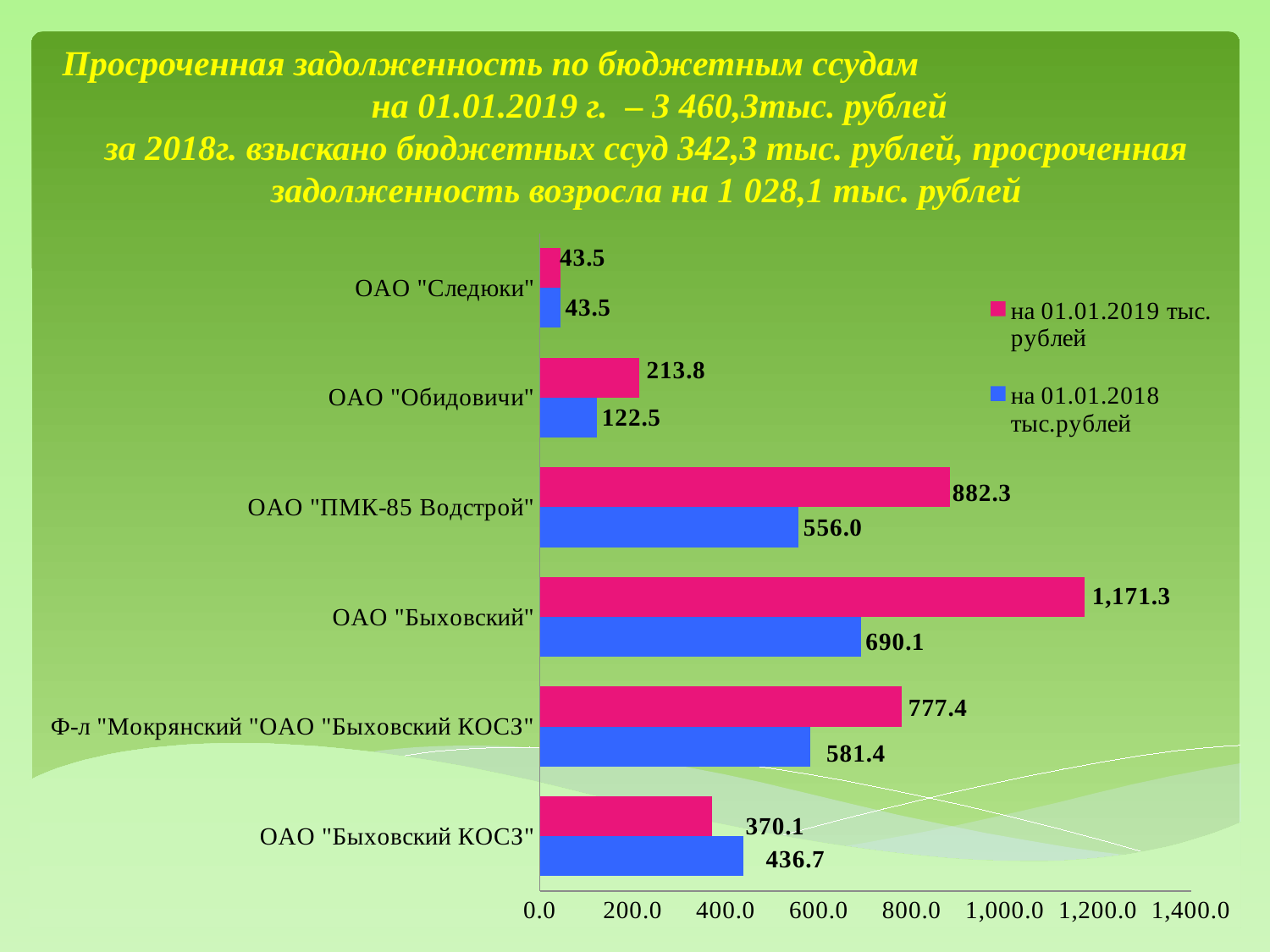
What kind of chart is shown on the slide? bar chart What is the value for ОАО "Быховский" in the series "на 01.01.2019 тыс. рублей"? 1,171.3 How many categories (organisations) are shown on the chart? 6 How many series does the legend list? 2 For ОАО "Быховский КОСЗ", which is larger: the value on 01.01.2019 or on 01.01.2018? 01.01.2018 What is the value for ОАО "Обидовичи" in the series "на 01.01.2019 тыс. рублей"? 213.8 Is the value for ОАО "ПМК-85 Водстрой" on 01.01.2019 greater or less than 800.0? greater What is the difference between the 01.01.2019 and 01.01.2018 values for ОАО "Быховский"? 481.2 What is the value for ОАО "ПМК-85 Водстрой" in the series "на 01.01.2018 тыс.рублей"? 556.0 Which category has the highest value in the series "на 01.01.2019 тыс. рублей"? ОАО "Быховский" Which colour represents the series "на 01.01.2018 тыс.рублей"? blue Which category has the lowest value in the series "на 01.01.2018 тыс.рублей"? ОАО "Следюки"